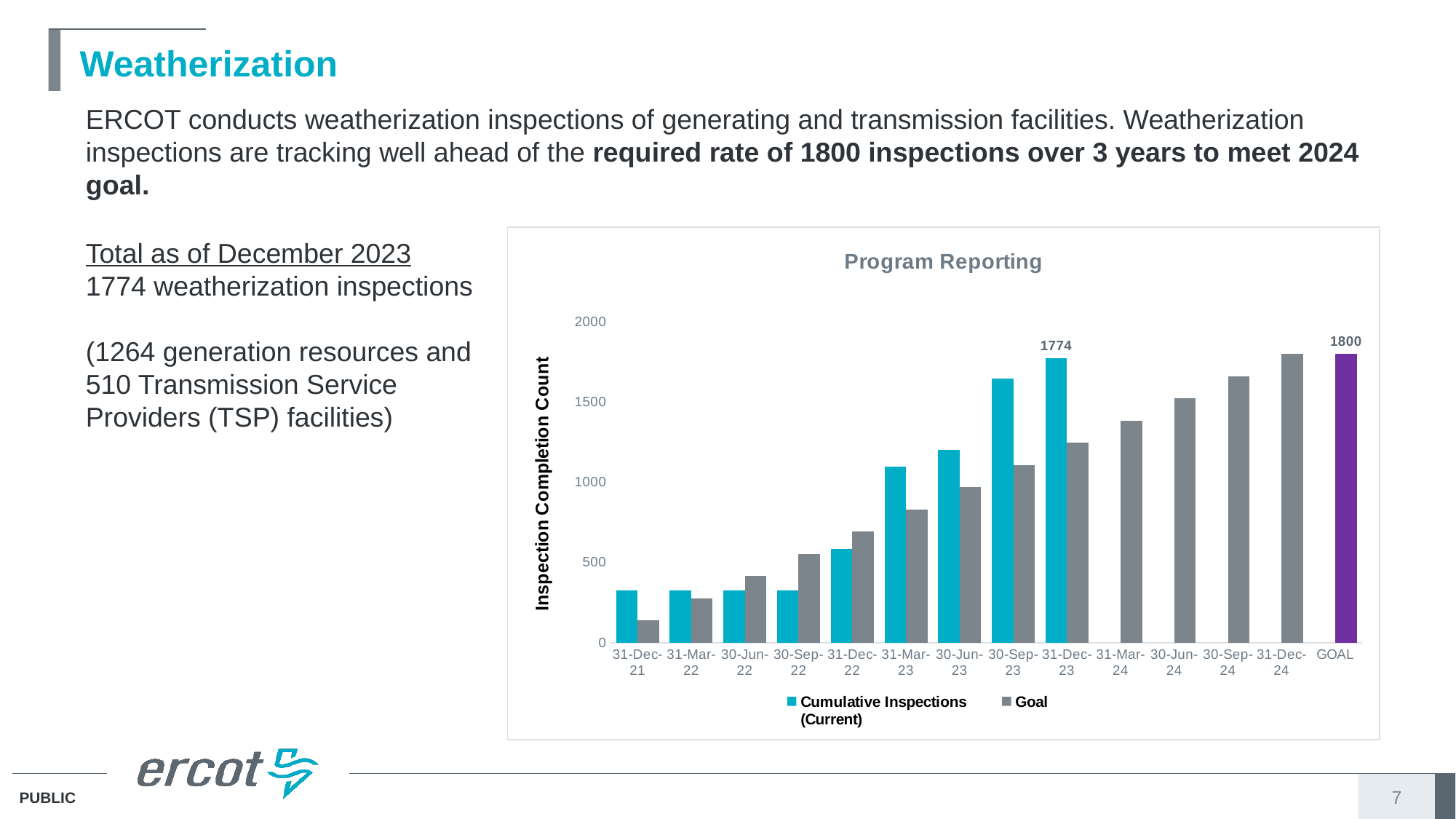
What is the difference between the GOAL bar value and the Cumulative Inspections (Current) value at 31-Dec-23? 26 Is the Goal value for 31-Dec-24 greater or less than 1500? greater Is the Cumulative Inspections (Current) value for 31-Dec-21 greater or less than 500? less How many categories are shown on the x axis of the chart? 14 What value is shown for the GOAL bar? 1800 What kind of chart is shown on the slide? bar chart How many series does the chart legend list? 2 Which date has the highest Cumulative Inspections (Current) bar? 31-Dec-23 What is the title of the chart? Program Reporting What is the value of Cumulative Inspections (Current) at 31-Dec-23? 1774 At 31-Dec-23, which is larger: Cumulative Inspections (Current) or Goal? Cumulative Inspections (Current) Do the Goal values rise or fall from 31-Dec-21 to 31-Dec-24? rise